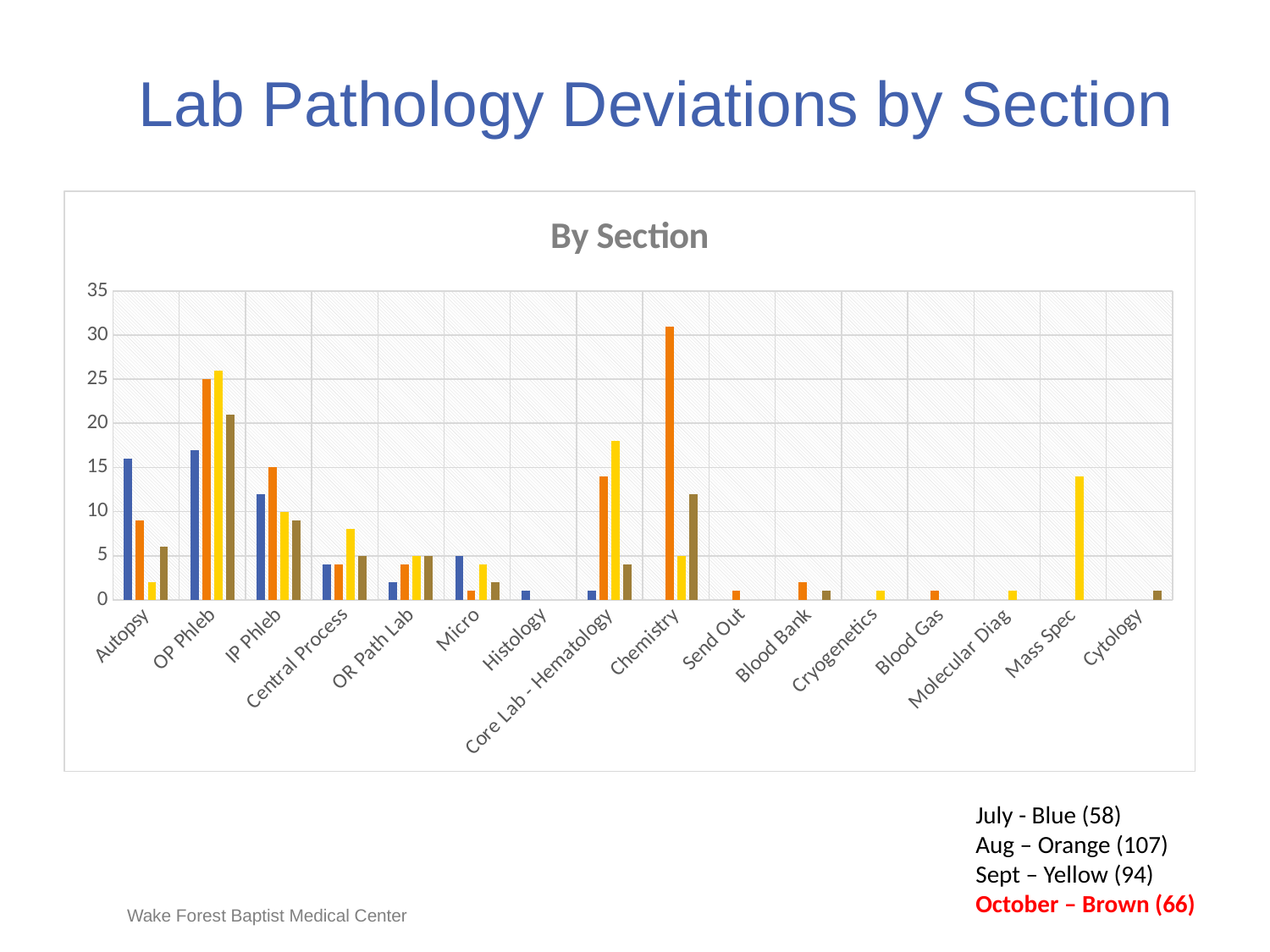
How many months (series) are plotted in the chart, according to the colour key below it? 4 Which colour represents September in the chart? Yellow Which is larger: the orange (Aug) bar for Chemistry or the yellow (Sept) bar for OP Phleb? the orange (Aug) bar for Chemistry How many sections (categories) are shown along the x axis of the chart? 16 Is the orange (Aug) bar for Chemistry greater or less than 30? greater Which section has the highest brown (October) bar? OP Phleb Which is larger: the yellow (Sept) bar for Core Lab - Hematology or the yellow (Sept) bar for Mass Spec? the yellow (Sept) bar for Core Lab - Hematology Which section has the highest yellow (Sept) bar? OP Phleb Which section has the tallest bar in the chart? Chemistry What kind of chart is shown on the slide? bar chart Is the yellow (Sept) bar for Mass Spec greater or less than 10? greater What is the title shown inside the chart area? By Section